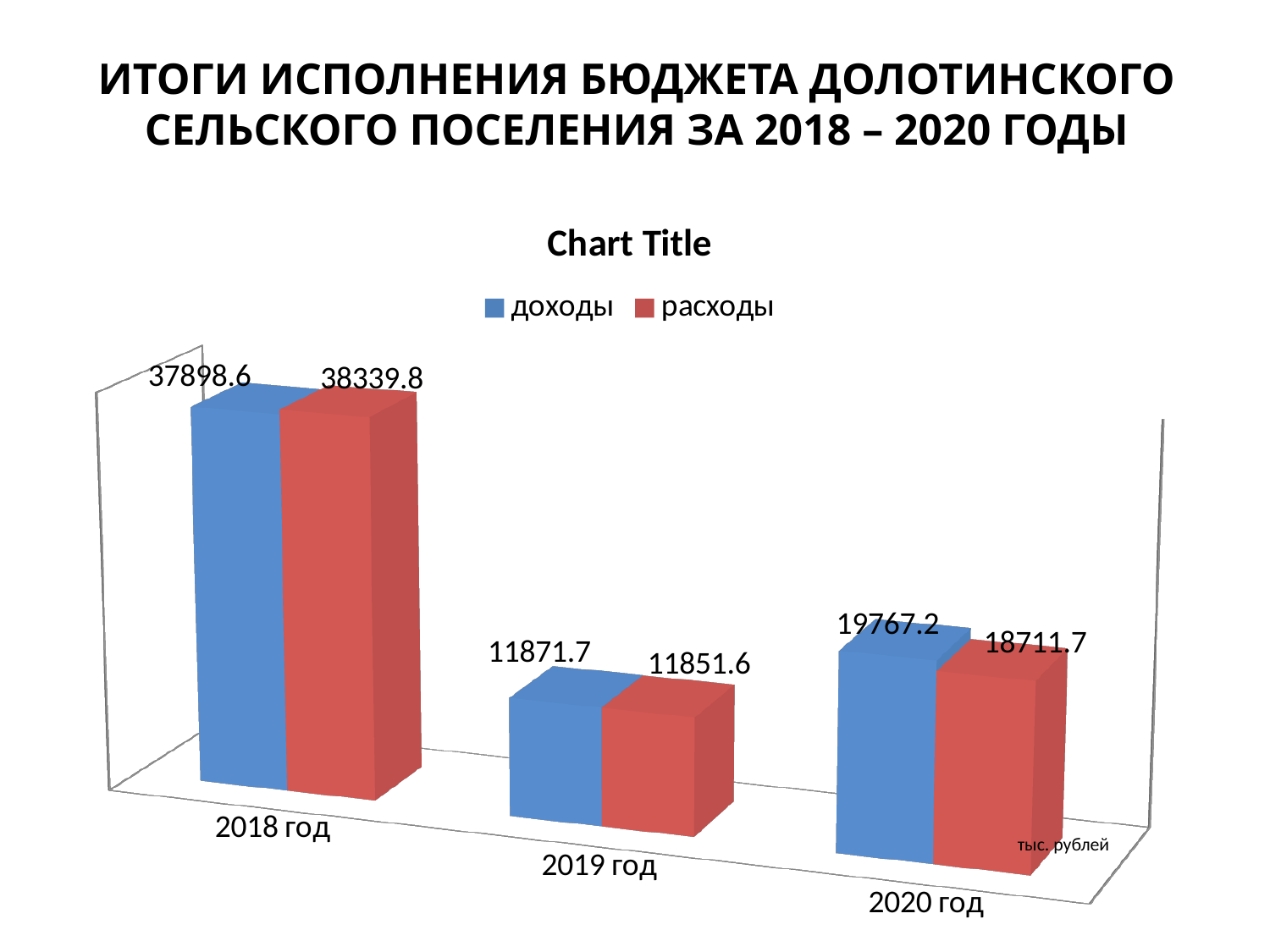
What is the value of расходы for 2020 год? 18711.7 In which year are доходы the highest? 2018 год Which is larger in 2018 год, доходы or расходы? расходы What is the value of расходы for 2019 год? 11851.6 Which is larger in 2020 год, доходы or расходы? доходы How many years (categories) are shown on the chart? 3 What is the difference between доходы and расходы in 2020 год? 1055.5 What kind of chart is shown on the slide? bar chart What is the difference between расходы and доходы in 2018 год? 441.2 In which year are расходы the lowest? 2019 год How many series does the legend list? 2 What is the value of доходы for 2018 год? 37898.6